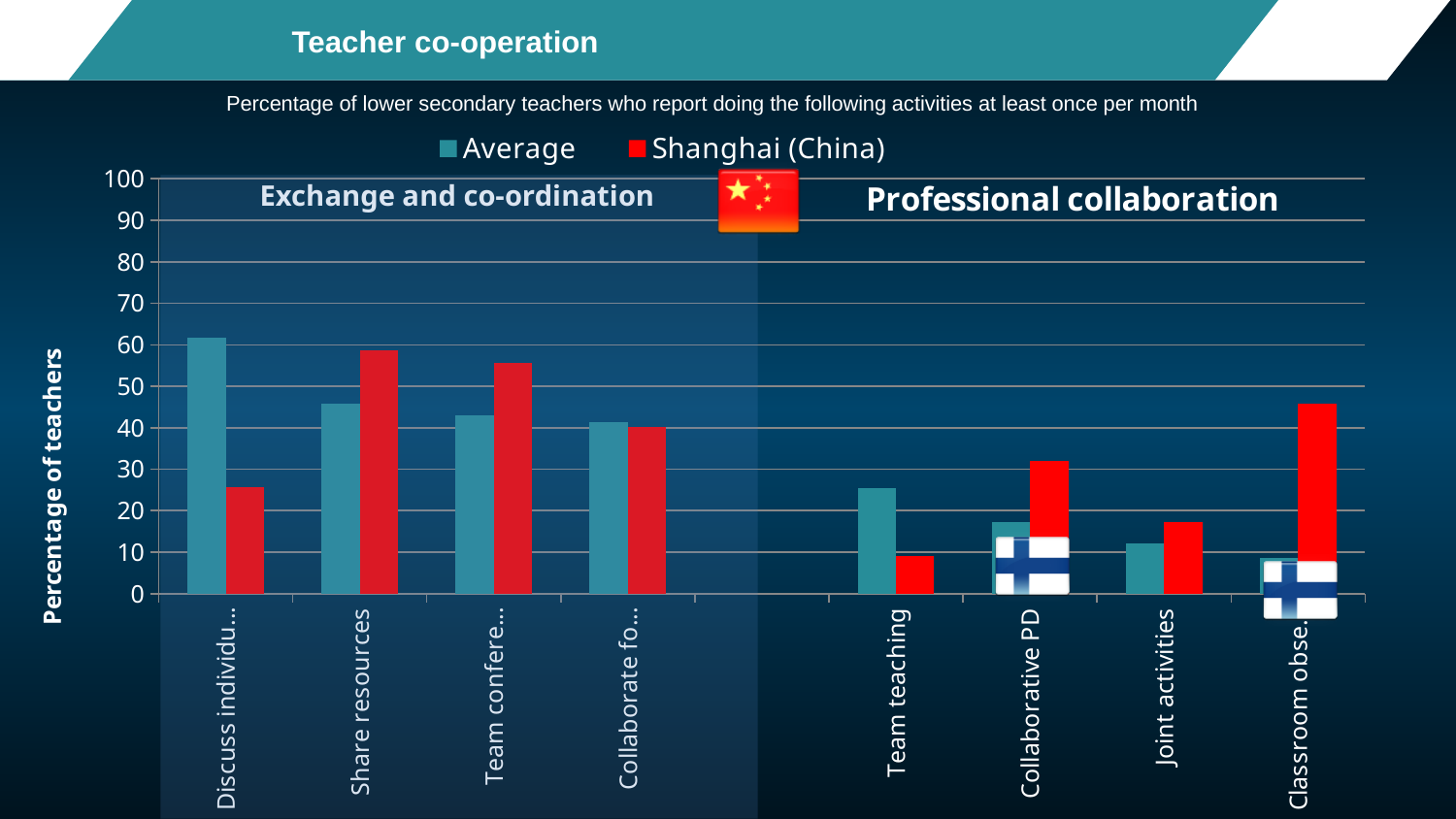
Is the Shanghai (China) value for Team teaching greater or less than 20? less How many activity categories are plotted along the x axis? 8 How many series does the legend list? 2 For Joint activities, which series has the larger value, Average or Shanghai (China)? Shanghai (China) What are the two series named in the legend? Average and Shanghai (China) Is the Shanghai (China) value for Share resources greater or less than 50? greater For Share resources, which series has the larger value, Average or Shanghai (China)? Shanghai (China) Is the Average value for Share resources greater or less than 50? less What kind of chart is shown on the slide? bar chart For Team teaching, which series has the larger value, Average or Shanghai (China)? Average What is the title of the vertical axis? Percentage of teachers